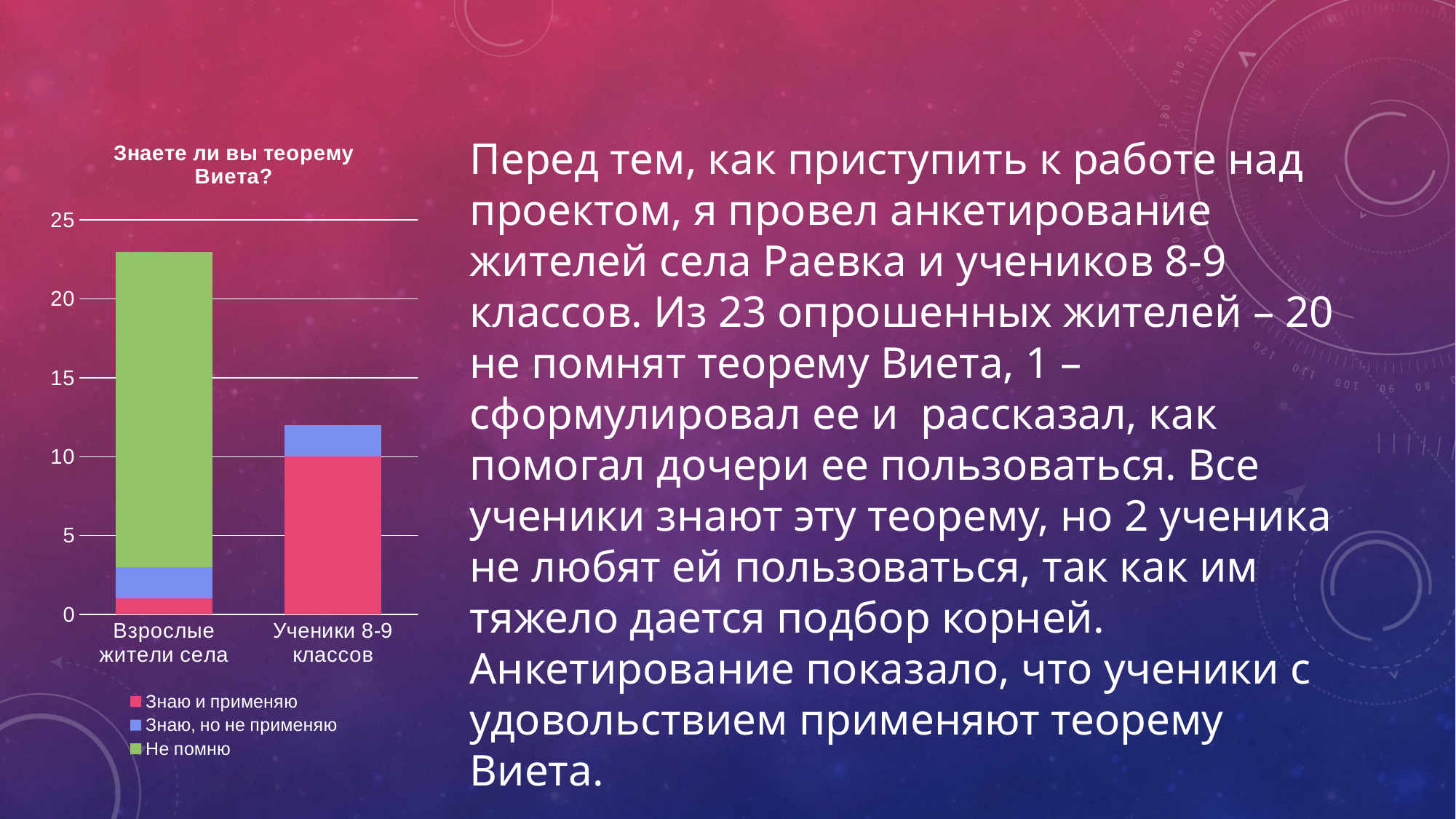
How many categories are shown on the x axis of the chart? 2 What kind of chart is shown on the slide? bar chart What is the value of "Знаю и применяю" for "Ученики 8-9 классов"? 10 Which series makes up the largest part of the bar for "Взрослые жители села"? Не помню Which colour represents the series "Не помню" in the chart? green For which category is the "Знаю и применяю" segment larger? Ученики 8-9 классов Is the total height of the stacked bar for "Взрослые жители села" greater or less than 20? greater Is the total height of the stacked bar for "Ученики 8-9 классов" greater or less than 15? less Is the value of "Знаю и применяю" for "Взрослые жители села" greater or less than 5? less What is the title of the chart? Знаете ли вы теорему Виета? Which category has the taller stacked bar overall? Взрослые жители села How many series does the chart's legend list? 3